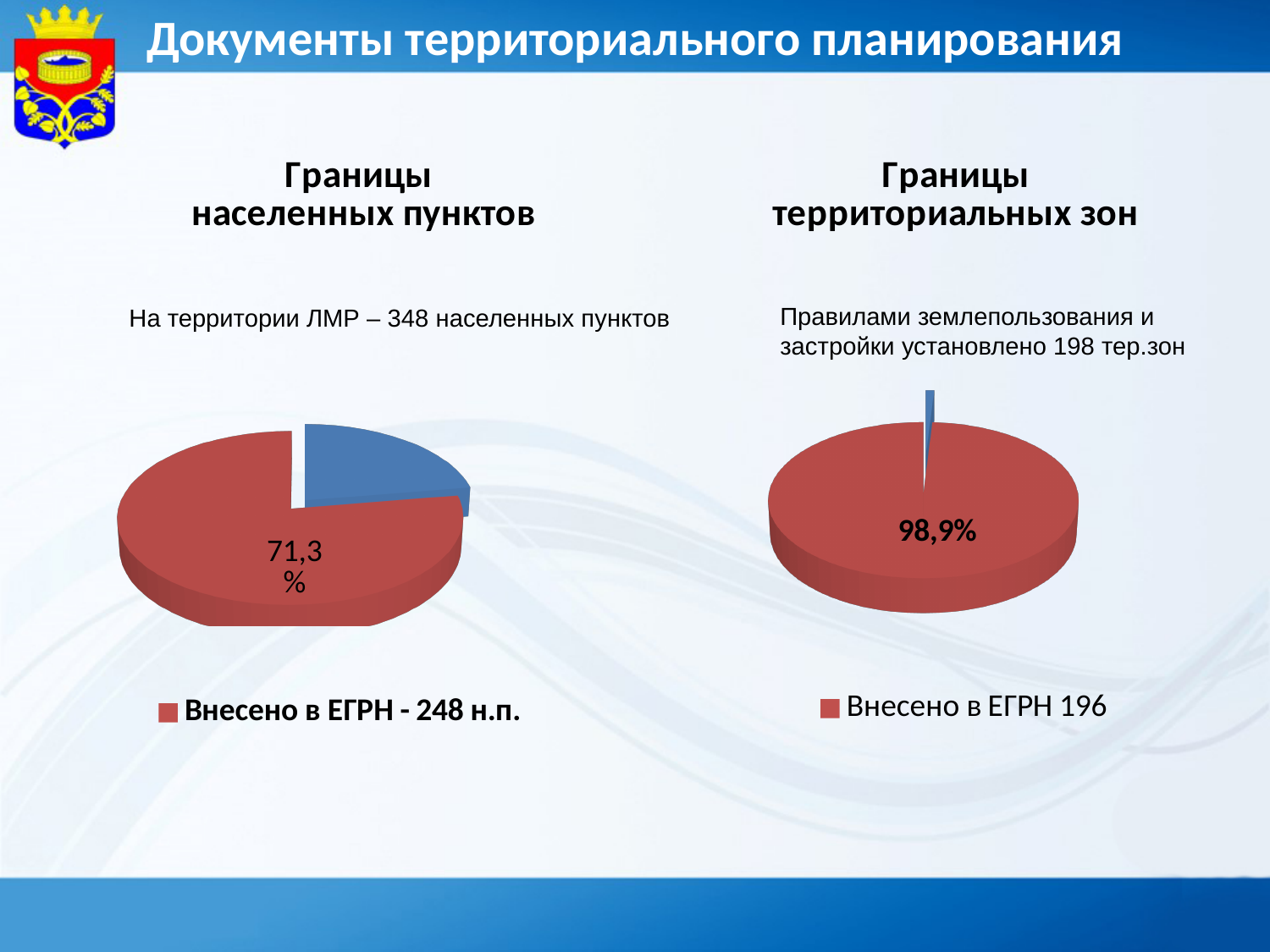
How many slices does the right pie chart (Границы территориальных зон) have? 2 How many slices does the left pie chart (Границы населенных пунктов) have? 2 Is the share printed on the red slice of the left pie chart (Границы населенных пунктов) greater or less than 50%? greater In the right pie chart (Границы территориальных зон), what share is printed on the red slice? 98,9% What kind of chart is shown under the heading "Границы населенных пунктов"? Pie chart What kind of chart is shown under the heading "Границы территориальных зон"? Pie chart What is the legend entry of the right pie chart (Границы территориальных зон)? Внесено в ЕГРН 196 What is the legend entry of the left pie chart (Границы населенных пунктов)? Внесено в ЕГРН - 248 н.п. How many entries does the legend of the left pie chart (Границы населенных пунктов) list? 1 In the right pie chart (Границы территориальных зон), which slice is larger, the red one or the blue one? The red one In the left pie chart (Границы населенных пунктов), what share is printed on the red slice? 71,3% In the left pie chart (Границы населенных пунктов), which slice is larger, the red one or the blue one? The red one